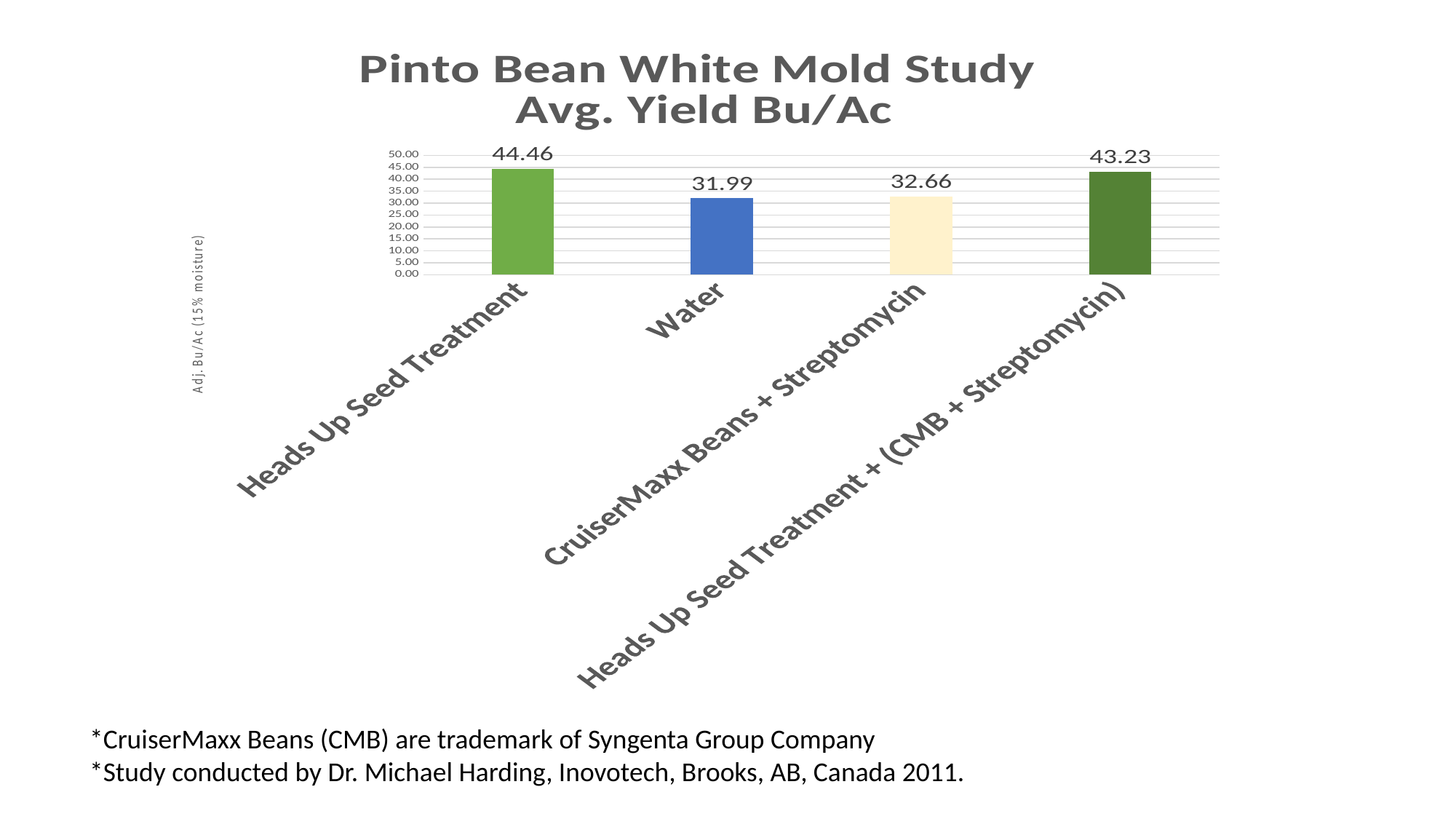
What is the average yield for Heads Up Seed Treatment? 44.46 What is the title of the chart? Pinto Bean White Mold Study Avg. Yield Bu/Ac What is the difference in average yield between Heads Up Seed Treatment and Heads Up Seed Treatment + (CMB + Streptomycin)? 1.23 Which treatment has the highest average yield? Heads Up Seed Treatment What is the average yield for CruiserMaxx Beans + Streptomycin? 32.66 What is the difference in average yield between Heads Up Seed Treatment and Water? 12.47 Which treatment has the lowest average yield? Water What is the average yield for Heads Up Seed Treatment + (CMB + Streptomycin)? 43.23 Which has a higher average yield, Water or CruiserMaxx Beans + Streptomycin? CruiserMaxx Beans + Streptomycin What is the average yield for Water? 31.99 How many treatments are shown in the chart? 4 What kind of chart is shown on the slide? Bar chart